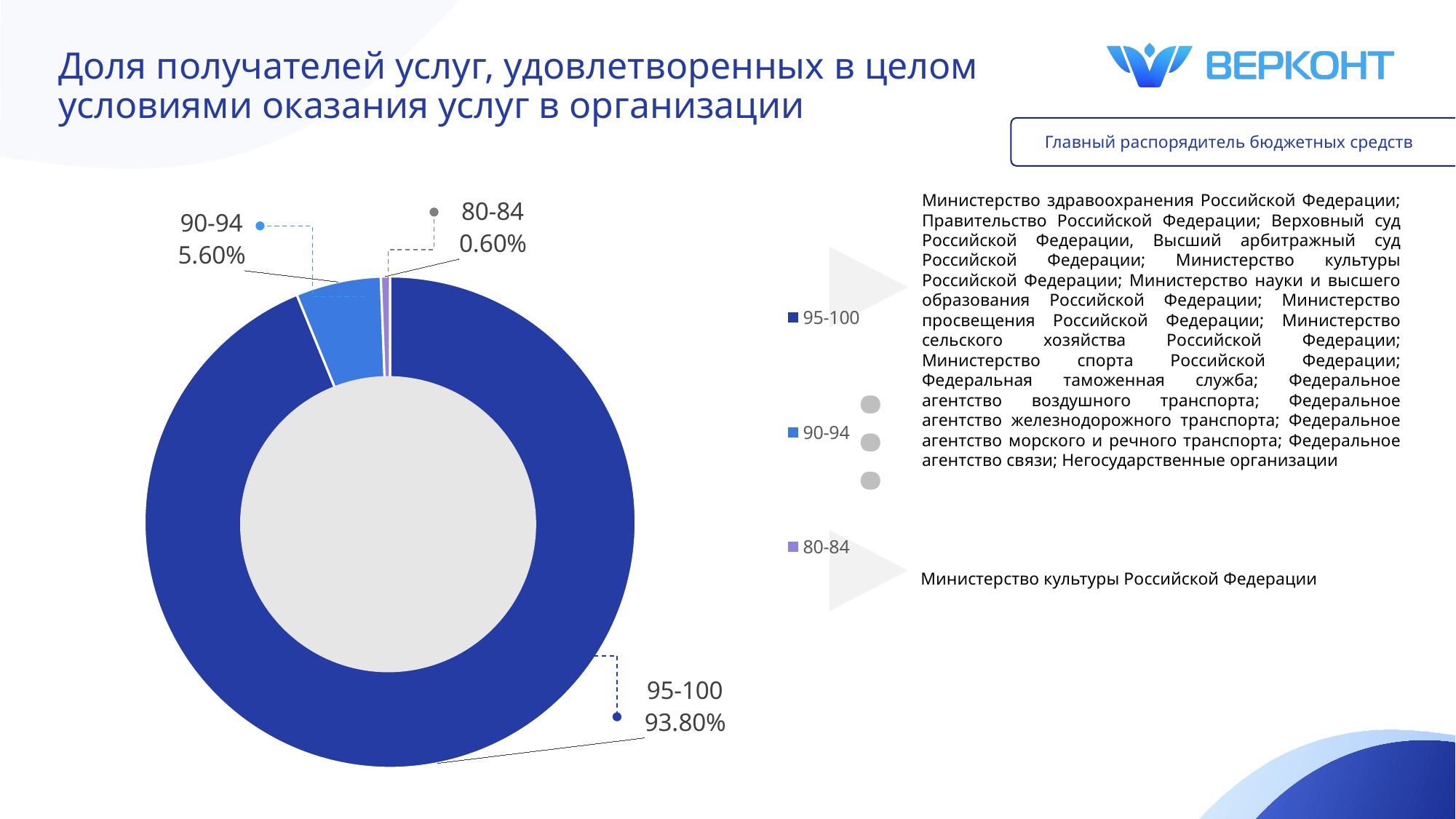
Which category has the smallest share of the pie? 80-84 What share of the pie does the 90-94 category hold? 5.60% What share of the pie does the 95-100 category hold? 93.80% What is the difference between the shares of the 90-94 and 80-84 categories? 5.00% How many categories are shown in the pie chart? 3 What colour is the 90-94 slice in the pie chart? Light blue Which category has a larger share: 90-94 or 80-84? 90-94 What is the difference between the shares of the 95-100 and 90-94 categories? 88.20% Which category has the largest share of the pie? 95-100 How many entries does the legend list? 3 What kind of chart is shown on the slide? Pie chart (doughnut) What share of the pie does the 80-84 category hold? 0.60%